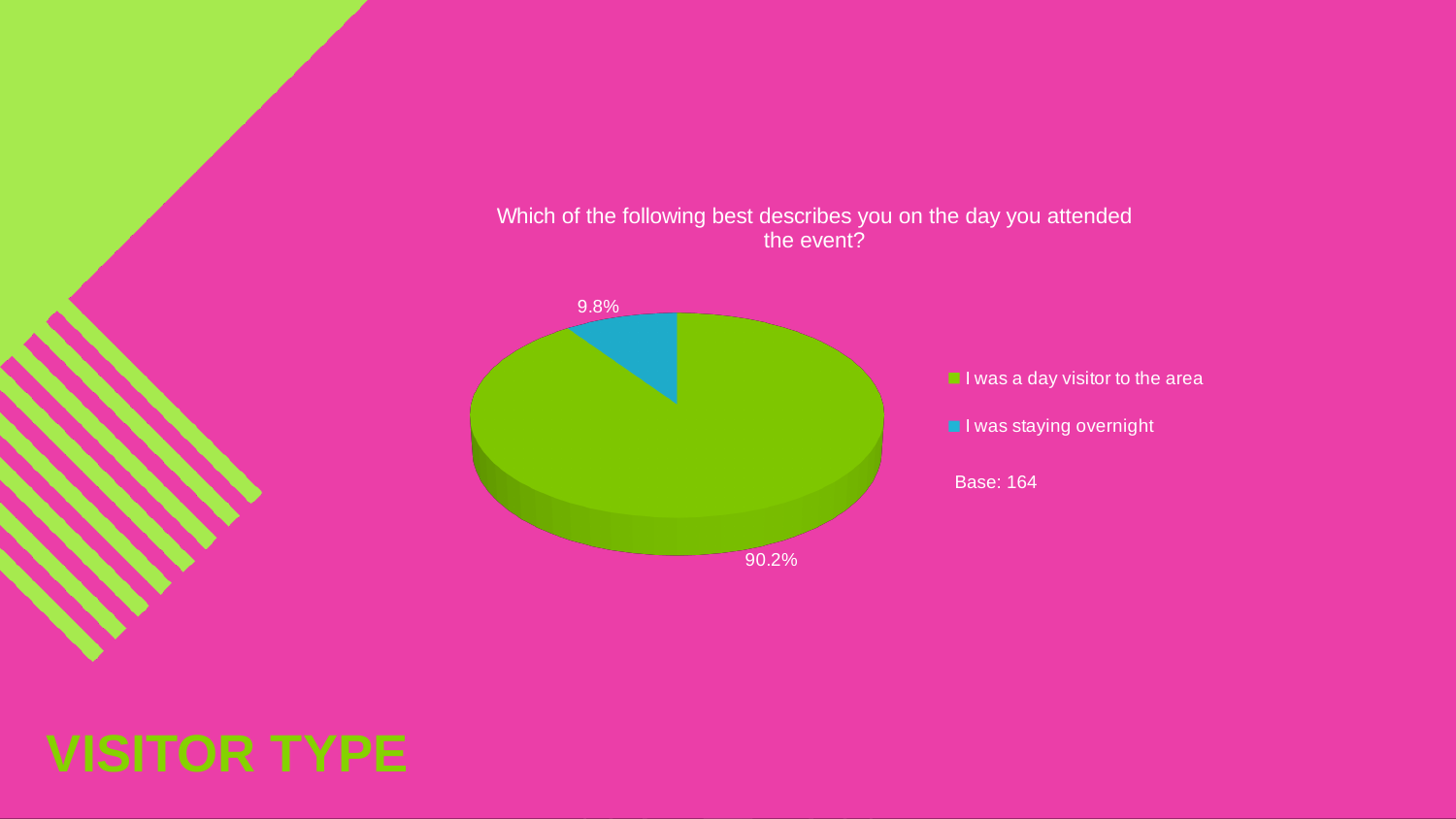
What is the base (number of respondents) shown next to the chart? 164 How many entries does the legend list? 2 Which category has the smallest slice of the pie? I was staying overnight How many categories does the pie chart show? 2 What share of respondents said "I was a day visitor to the area"? 90.2% Which is larger: the share for "I was a day visitor to the area" or "I was staying overnight"? I was a day visitor to the area Which category has the largest slice of the pie? I was a day visitor to the area What share of respondents said "I was staying overnight"? 9.8% What is the title of the chart? Which of the following best describes you on the day you attended the event? What is the difference in percentage points between day visitors and overnight visitors? 80.4 What colour is the slice for "I was staying overnight"? blue What kind of chart is shown on the slide? pie chart